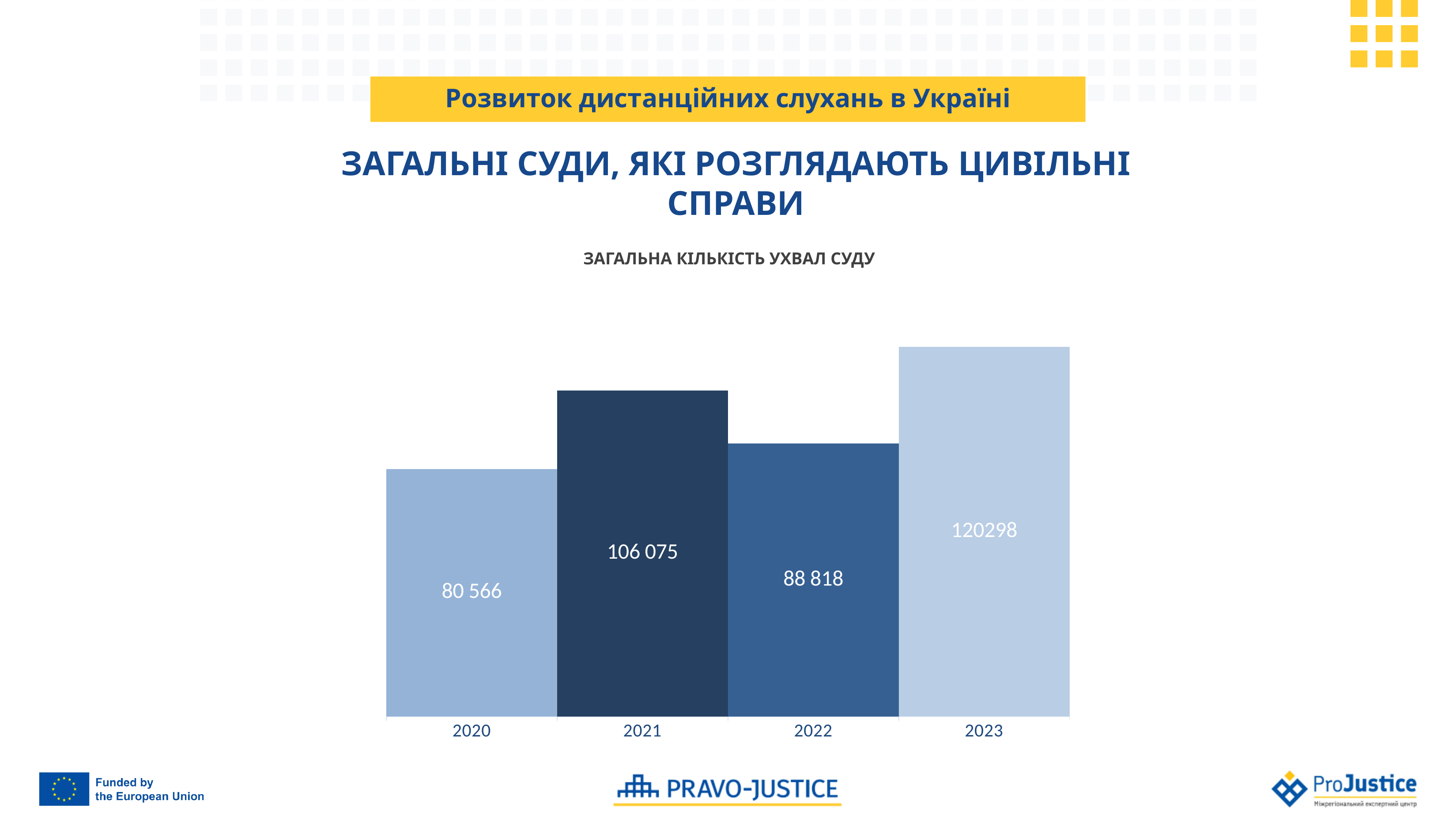
What is the difference between the values for 2021 and 2022? 17257 Which is larger, the value for 2021 or the value for 2022? 2021 What is the value for 2021? 106 075 Which year has the highest value? 2023 Which year has the lowest value? 2020 How many years are shown on the chart? 4 What is the value for 2023? 120298 What is the value for 2020? 80 566 What is the difference between the values for 2023 and 2020? 39732 What is the value for 2022? 88 818 Does the value rise or fall from 2021 to 2022? fall What kind of chart is shown on the slide? bar chart